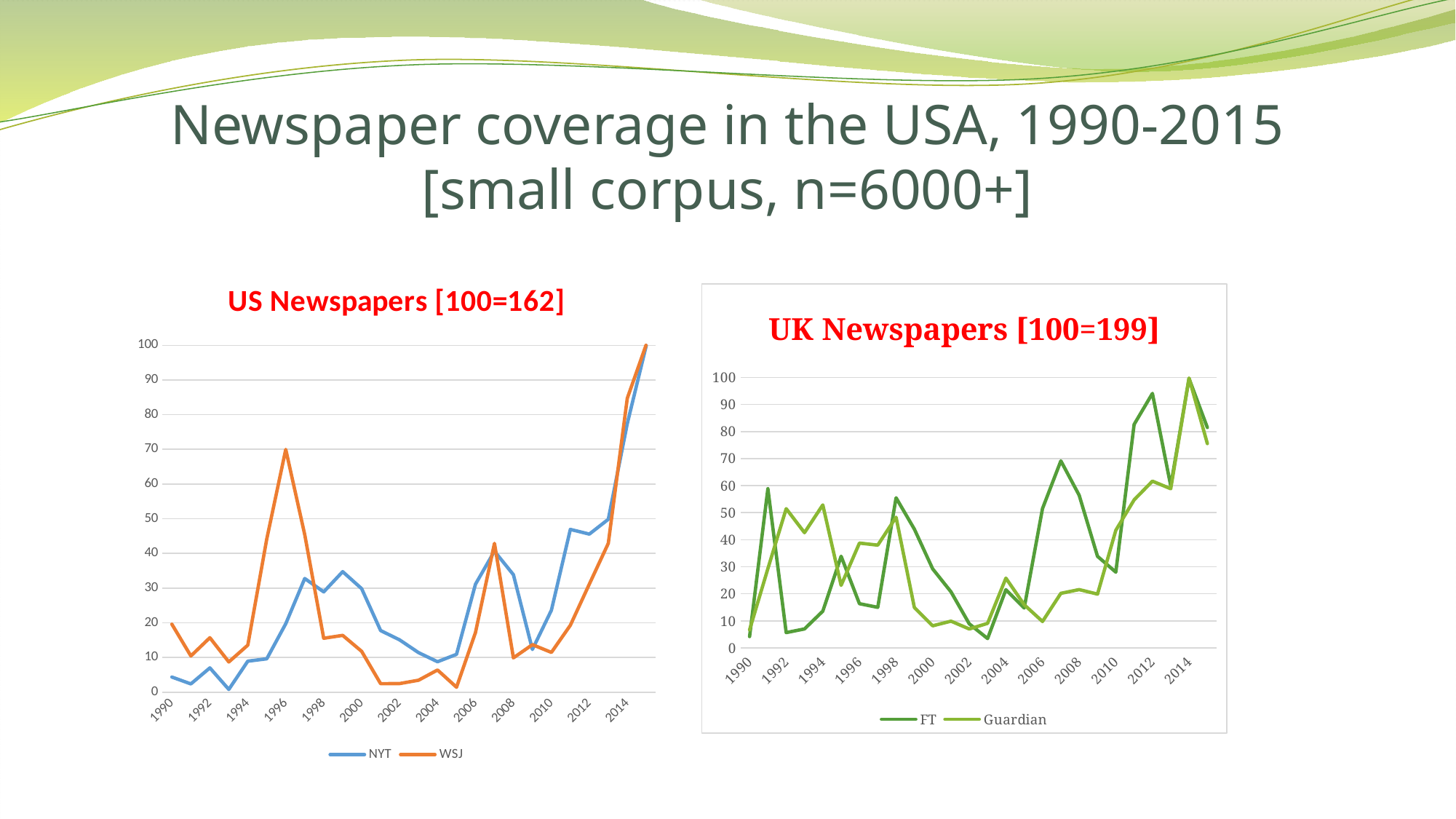
In the US Newspapers chart, is the value for WSJ in 1996 greater or less than 60? greater What kind of chart is the US Newspapers chart on the left? line chart What is the title of the chart on the right of the slide? UK Newspapers [100=199] In the US Newspapers chart, is the value for NYT in 1993 greater or less than 10? less In the US Newspapers chart, what is the value for WSJ in 2015? 100 In the UK Newspapers chart, is the value for FT in 2008 greater or less than 60? less What are the two series named in the legend of the US Newspapers chart? NYT and WSJ In the US Newspapers chart, which series has the larger value in 1996, NYT or WSJ? WSJ In the UK Newspapers chart, which series has the larger value in 2012, FT or Guardian? FT In the UK Newspapers chart, in which year does the Guardian series reach its highest value? 2014 How many series does the legend of the UK Newspapers chart list? 2 In the UK Newspapers chart, what is the value for Guardian in 2014? 100